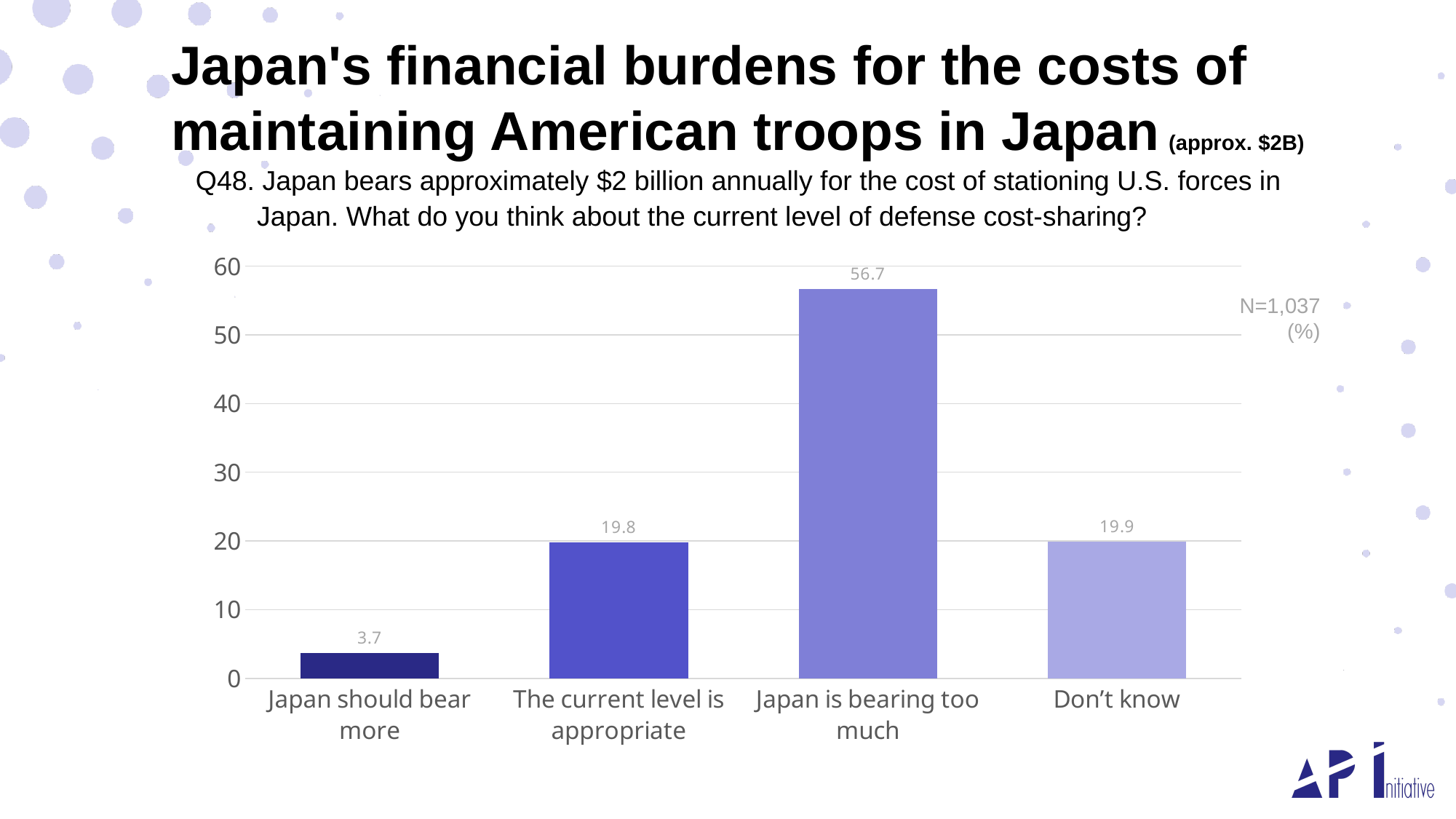
What is the value for "Don't know"? 19.9 What is the value for "Japan should bear more"? 3.7 What sample size (N) is shown next to the chart? N=1,037 What is the value for "Japan is bearing too much"? 56.7 Which category has the lowest value? Japan should bear more What kind of chart is shown on the slide? bar chart Is the value for "Japan is bearing too much" greater or less than 50? greater Which category has the highest value? Japan is bearing too much Which is larger: the value for "Japan is bearing too much" or the value for "Don't know"? Japan is bearing too much What is the difference between the values for "Japan is bearing too much" and "The current level is appropriate"? 36.9 How many categories are shown on the x axis? 4 What is the value for "The current level is appropriate"? 19.8